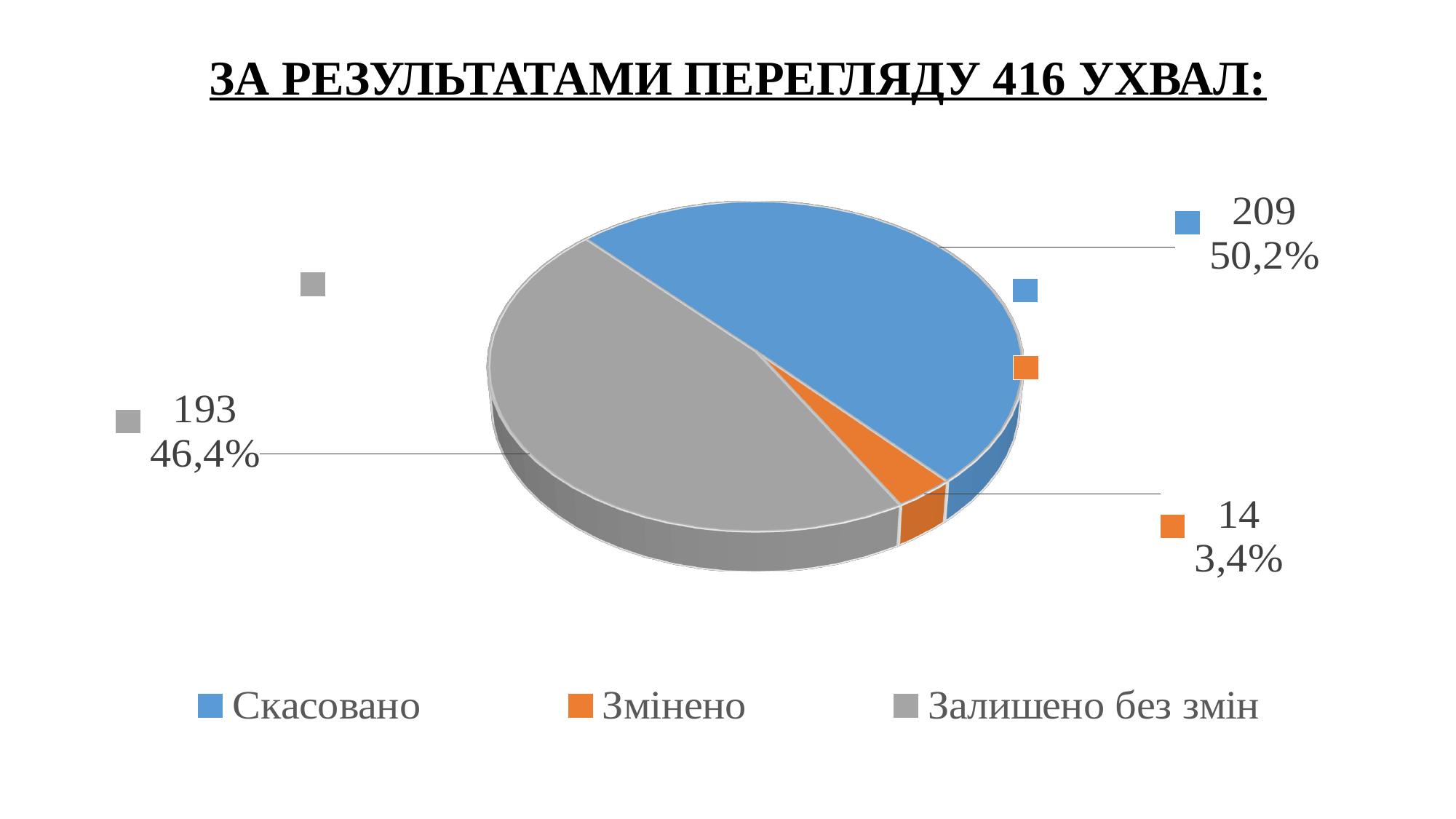
What is the value for Залишено без змін? 193 What share of the pie does Змінено represent? 3,4% Which category has the largest slice? Скасовано What is the difference between the values for Скасовано and Залишено без змін? 16 What share of the pie does Залишено без змін represent? 46,4% How many categories does the pie chart have? 3 What kind of chart is shown on the slide? pie chart What colour is the slice for Змінено? orange Which category has the smallest slice? Змінено What is the value for Скасовано? 209 What share of the pie does Скасовано represent? 50,2% What is the value for Змінено? 14